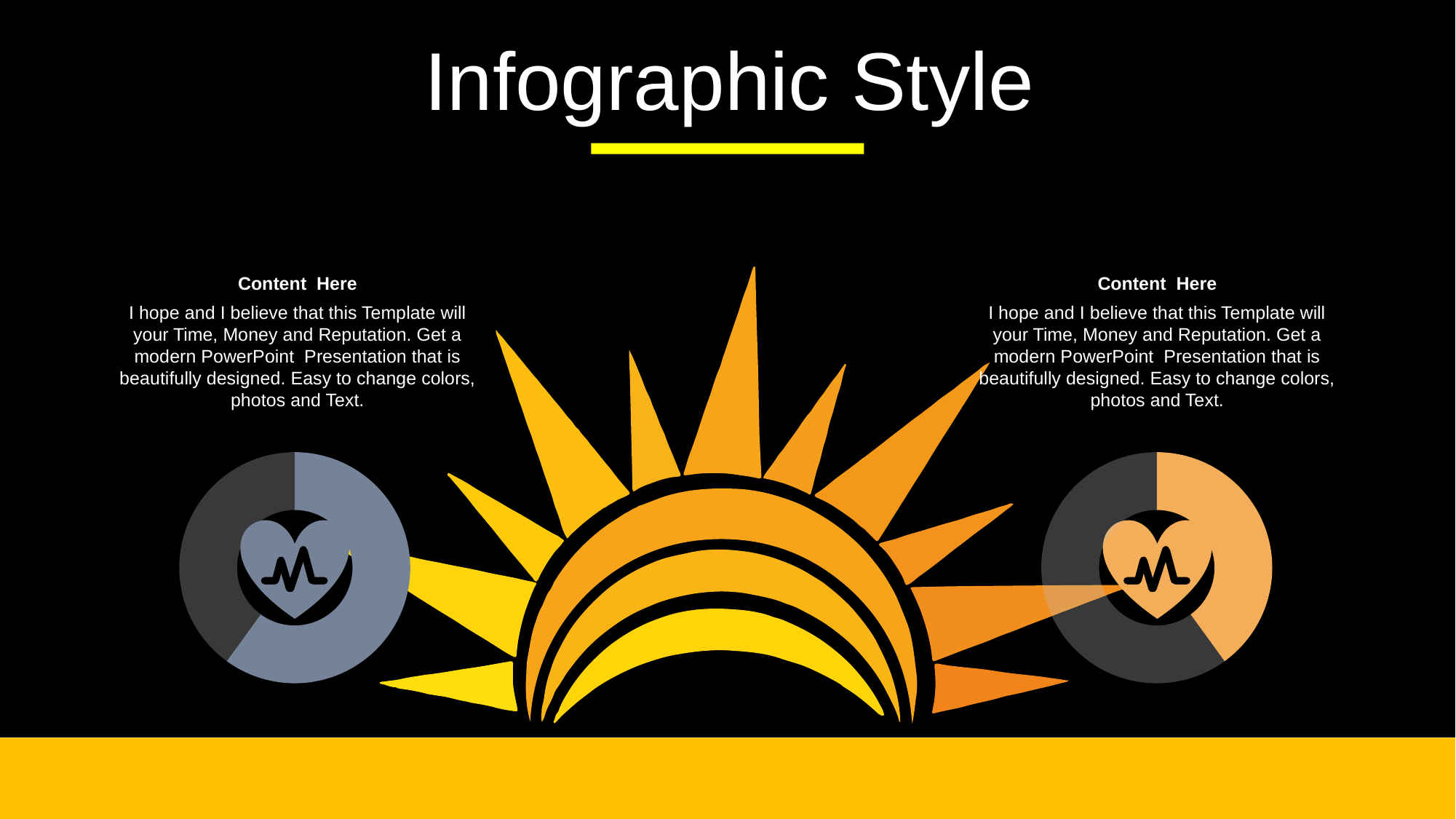
How many slices does the chart on the right side of the slide have? 2 In the chart on the left side of the slide, does the dark grey slice cover more or less than half of the pie? less In the chart on the right side of the slide, does the orange slice cover more or less than half of the pie? more What kind of chart is the chart on the right side of the slide? pie chart What icon is shown in the centre of each pie chart on the slide? a heart with a heartbeat line How many slices does the chart on the left side of the slide have? 2 How many pie charts are shown on the slide? 2 What kind of chart is the chart on the left side of the slide? pie chart In the chart on the left side of the slide, which slice is larger, the blue-grey slice or the dark grey slice? the blue-grey slice What colour is the larger slice of the chart on the right side of the slide? orange